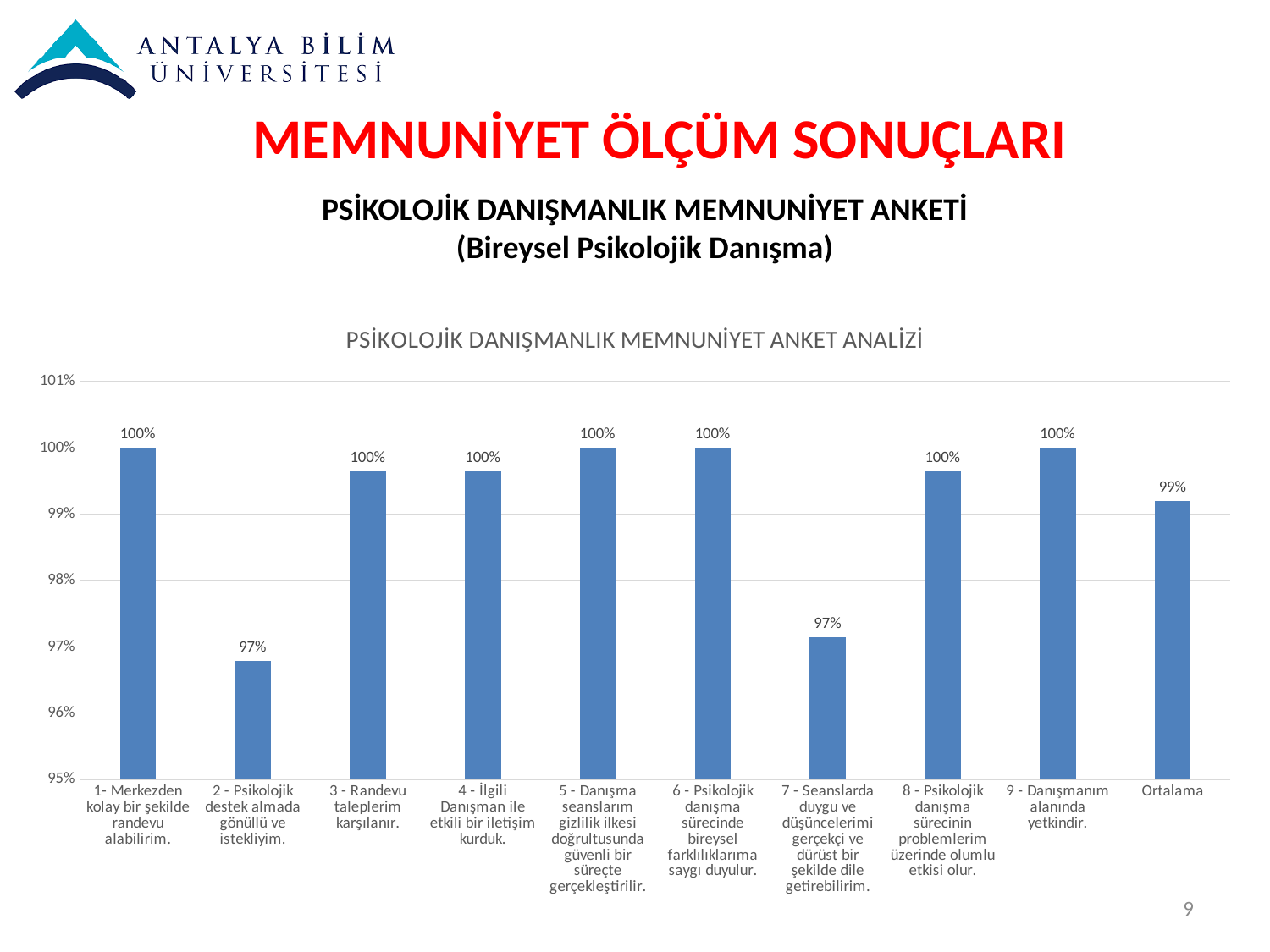
Which is larger: the value for "9 - Danışmanım alanında yetkindir." or the value for "Ortalama"? 9 - Danışmanım alanında yetkindir. What is the difference between the value for "1- Merkezden kolay bir şekilde randevu alabilirim." and the value for "Ortalama"? 1% What is the value shown for "2 - Psikolojik destek almada gönüllü ve istekliyim."? 97% What is the title of the chart? PSİKOLOJİK DANIŞMANLIK MEMNUNİYET ANKET ANALİZİ How many categories are shown on the x axis? 10 What is the value shown for "Ortalama"? 99% What is the value shown for "7 - Seanslarda duygu ve düşüncelerimi gerçekçi ve dürüst bir şekilde dile getirebilirim."? 97% Is the value for "Ortalama" greater or less than 98%? greater What is the value shown for "1- Merkezden kolay bir şekilde randevu alabilirim."? 100% What is the difference between the value for "1- Merkezden kolay bir şekilde randevu alabilirim." and the value for "2 - Psikolojik destek almada gönüllü ve istekliyim."? 3% What kind of chart is shown on the slide? bar chart Which category has the lowest bar? 2 - Psikolojik destek almada gönüllü ve istekliyim.